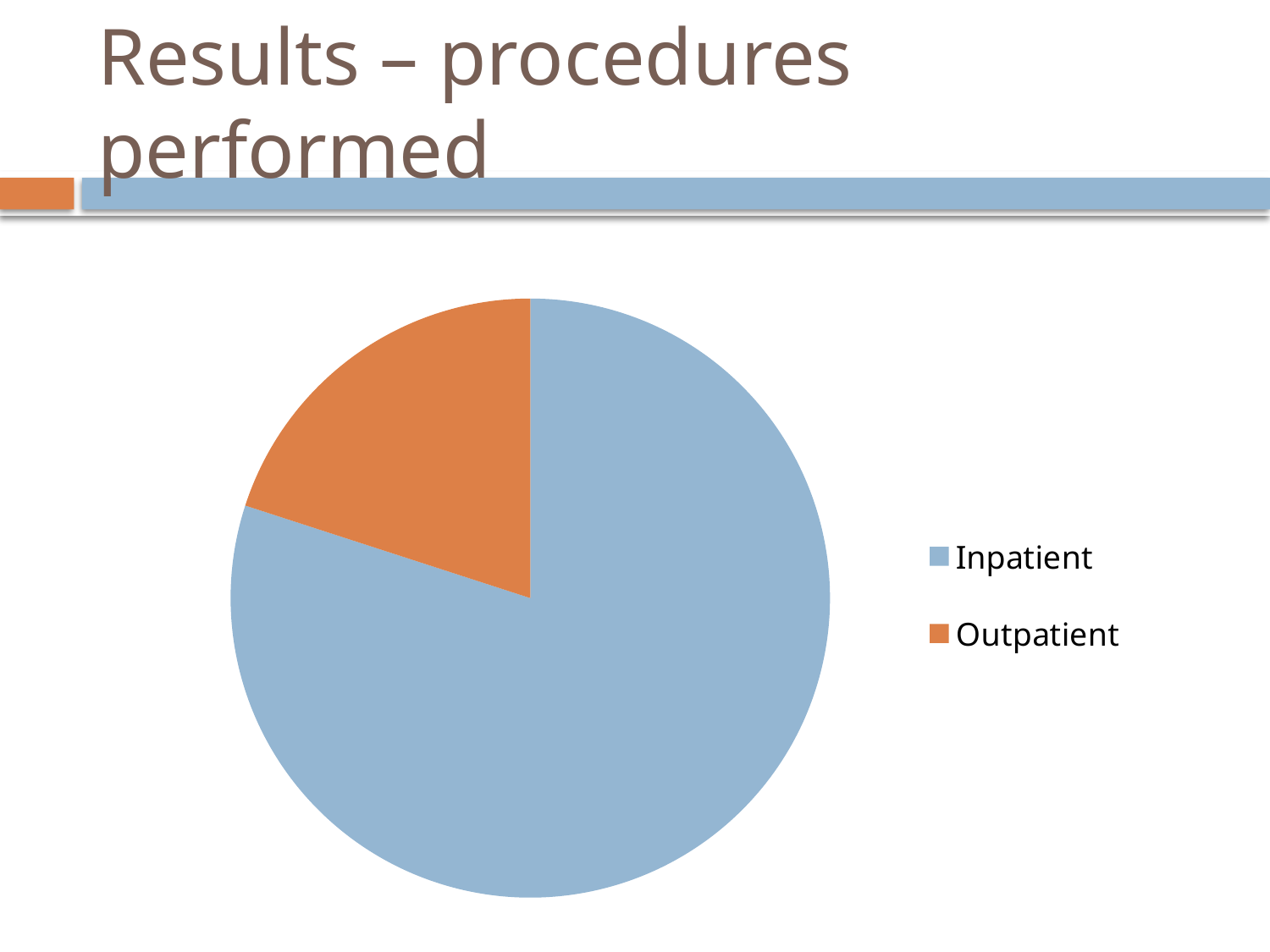
How many slices does the pie chart have? 2 Which category has the smallest slice of the pie? Outpatient Is the Outpatient share of the pie greater or less than 50%? less Which slice is larger, Inpatient or Outpatient? Inpatient Which category has the largest slice of the pie? Inpatient How many entries does the legend list? 2 What kind of chart is shown on the slide? pie chart Is the Inpatient share of the pie greater or less than 50%? greater What colour is the Inpatient slice? blue What colour is the Outpatient slice? orange